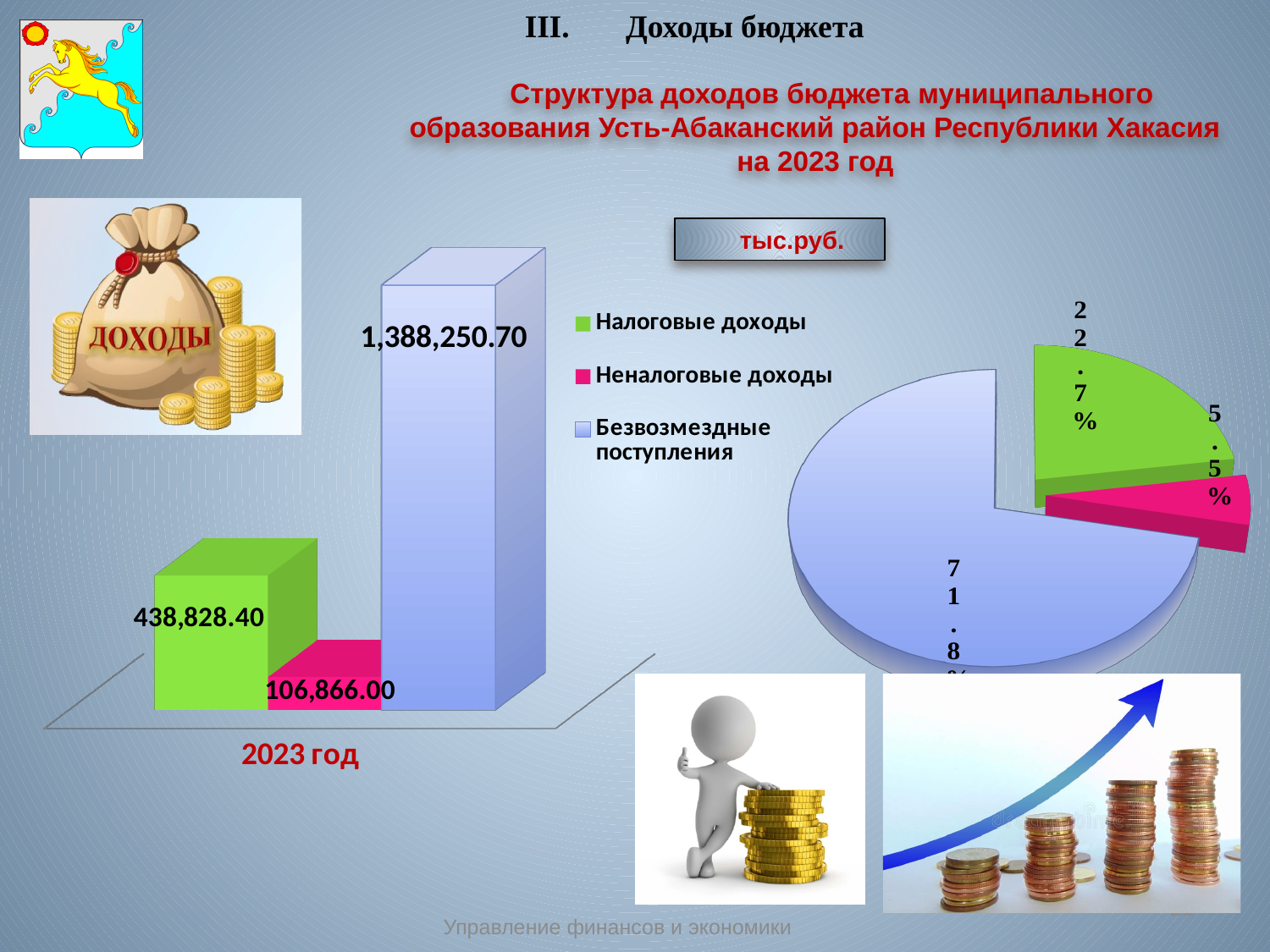
What kind of chart is the chart on the left of the slide? bar chart On the bar chart, which series has the lowest value? Неналоговые доходы On the bar chart, what is the difference between Налоговые доходы and Неналоговые доходы? 331,962.40 On the pie chart, what share does the pink slice (Неналоговые доходы) have? 5.5% How many series does the legend of the bar chart list? 3 What kind of chart is the chart on the right of the slide? pie chart On the bar chart, which is larger: Налоговые доходы or Неналоговые доходы? Налоговые доходы On the pie chart, what share does the green slice (Налоговые доходы) have? 22.7% On the bar chart, what is the value for Безвозмездные поступления in 2023 год? 1,388,250.70 On the bar chart, what is the value for Неналоговые доходы in 2023 год? 106,866.00 On the bar chart, what is the value for Налоговые доходы in 2023 год? 438,828.40 On the bar chart, which series has the highest value? Безвозмездные поступления